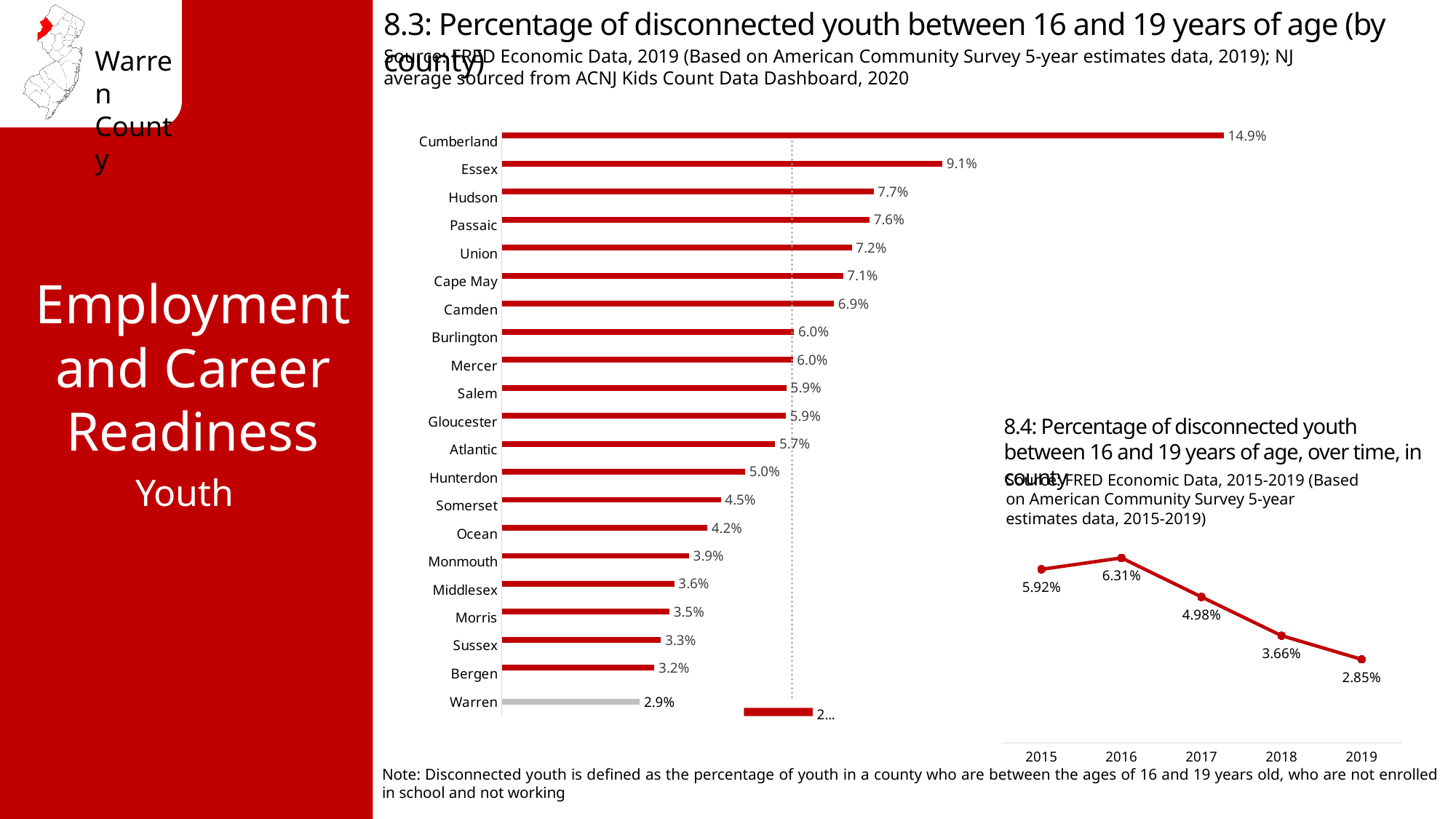
In chart 8.4 (percentage of disconnected youth over time in county), do the values rise or fall from 2016 to 2019? Fall In chart 8.3 (percentage of disconnected youth by county), what is the value for Essex? 9.1% In chart 8.4 (percentage of disconnected youth over time in county), what is the value for 2019? 2.85% What kind of chart is chart 8.3 (percentage of disconnected youth by county)? Bar chart In chart 8.3 (percentage of disconnected youth by county), which county has the highest value? Cumberland In chart 8.3 (percentage of disconnected youth by county), how many counties are shown? 21 In chart 8.4 (percentage of disconnected youth over time in county), what is the difference between 2016 and 2019? 3.46% In chart 8.4 (percentage of disconnected youth over time in county), which year has the highest value? 2016 In chart 8.3 (percentage of disconnected youth by county), which is larger, Hunterdon or Somerset? Hunterdon In chart 8.3 (percentage of disconnected youth by county), what is the difference between Cumberland and Warren? 12.0% In chart 8.3 (percentage of disconnected youth by county), which county has the lowest value? Warren In chart 8.3 (percentage of disconnected youth by county), what is the value for Warren? 2.9%